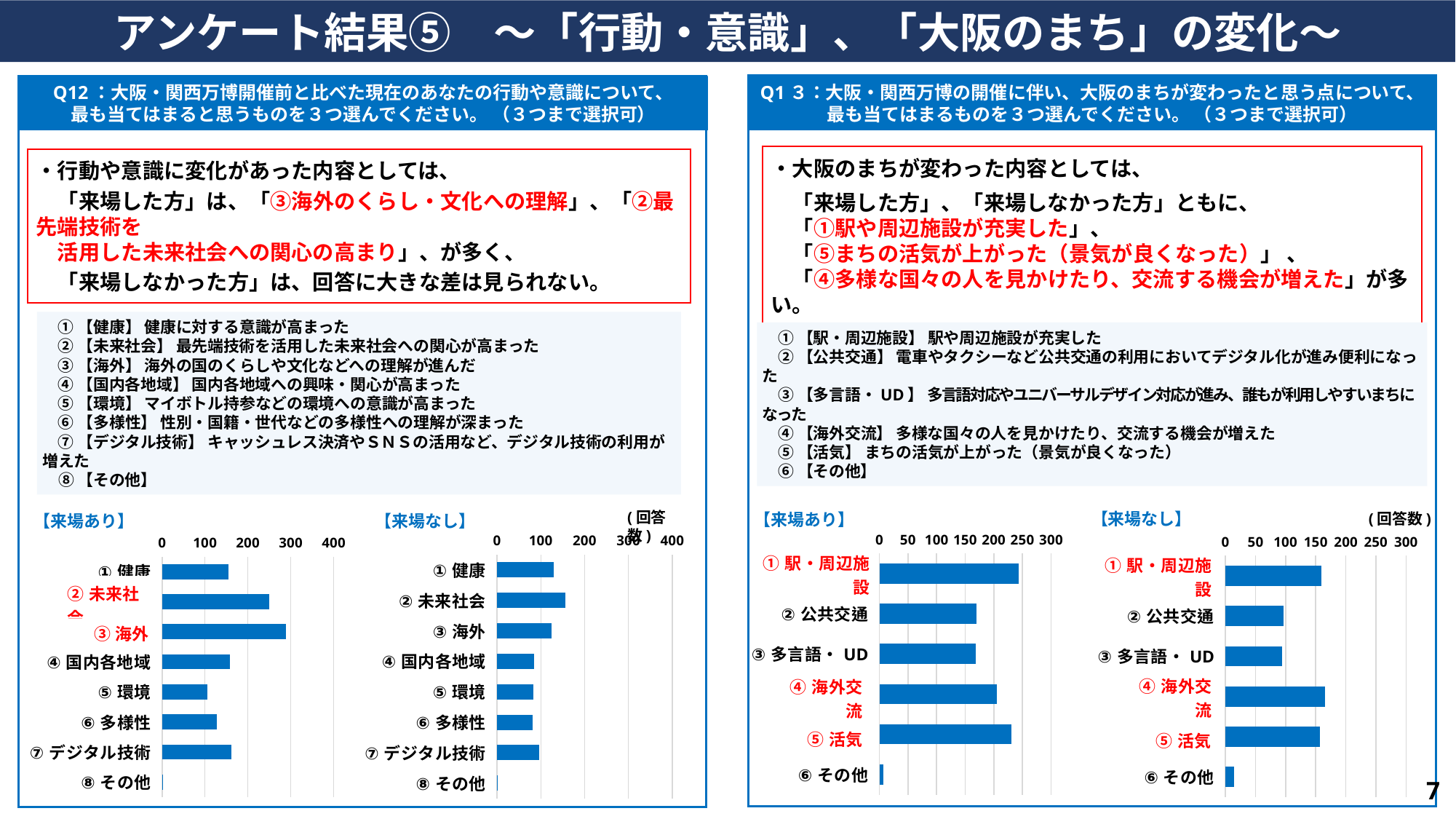
On the Q12 【来場あり】 chart, is the value for ⑤ 環境 greater or less than 200? less On the Q13 【来場あり】 chart, is the value for ⑤ 活気 greater or less than 200? greater On the Q12 【来場あり】 chart, is the value for ③ 海外 greater or less than 200? greater On the Q12 【来場あり】 chart, how many categories are plotted? 8 On the Q13 【来場なし】 chart, which is larger, ④ 海外交流 or ② 公共交通? ④ 海外交流 On the Q12 【来場あり】 chart, what kind of chart is used? bar chart On the Q13 【来場あり】 chart, which category has the highest value? ① 駅・周辺施設 On the Q12 【来場あり】 chart, which is larger, ② 未来社会 or ① 健康? ② 未来社会 On the Q13 【来場あり】 chart, how many categories are plotted? 6 On the Q12 【来場あり】 chart, which category has the highest value? ③ 海外 On the Q12 【来場なし】 chart, which category has the highest value? ② 未来社会